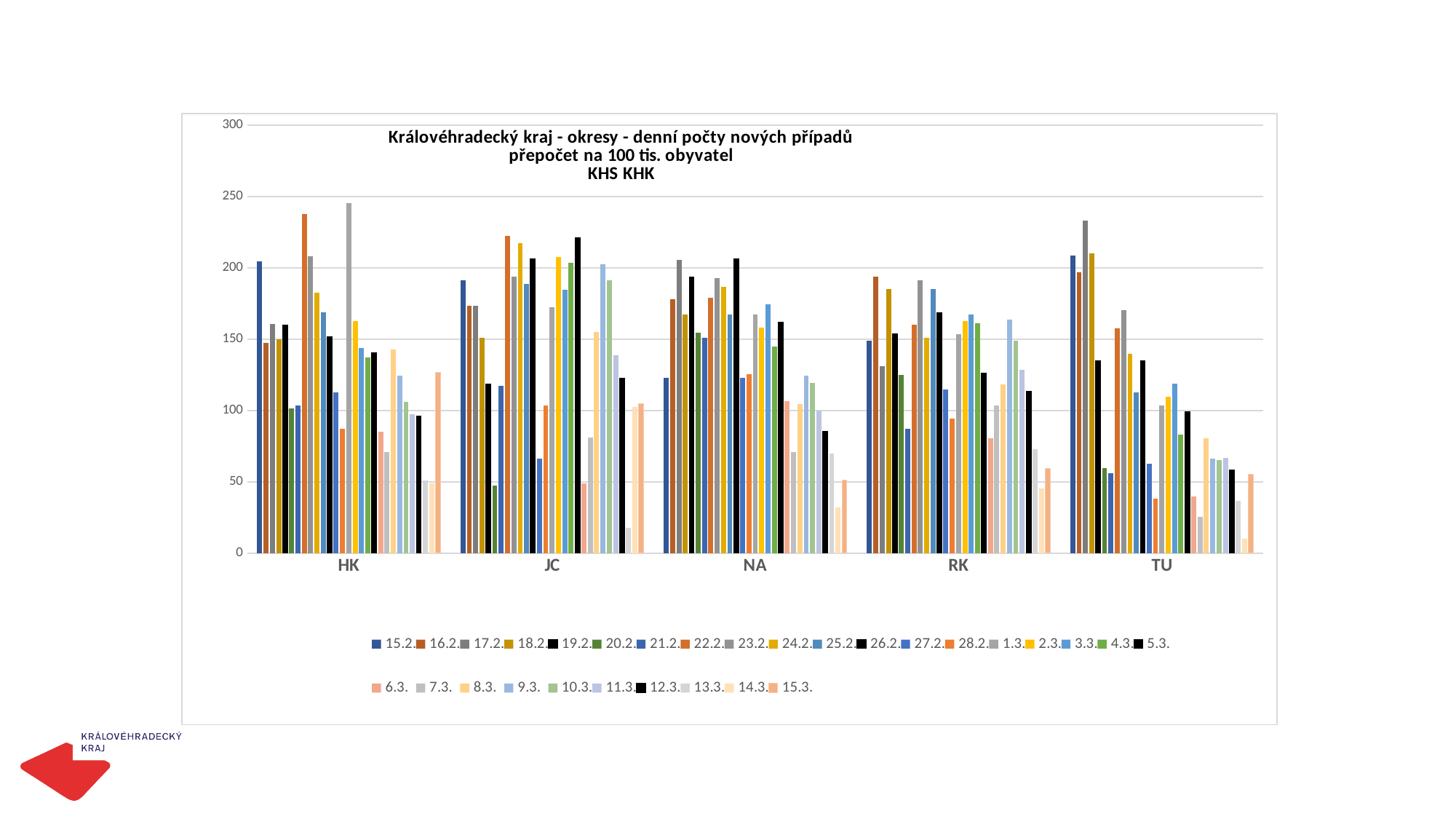
Is the value for 15.3. in NA greater or less than 100? less Is the value for 15.3. in TU greater or less than 100? less Is the value for 15.3. in HK greater or less than 100? greater How many series (dates) does the legend list? 29 What is the first date listed in the legend? 15.2. What kind of chart is shown on the slide? bar chart Which is larger, the value for 15.2. in HK or the value for 15.2. in NA? 15.2. in HK How many district categories are shown on the x axis? 5 Which date has the highest value in the TU group? 17.2. What is the last date listed in the legend? 15.3.